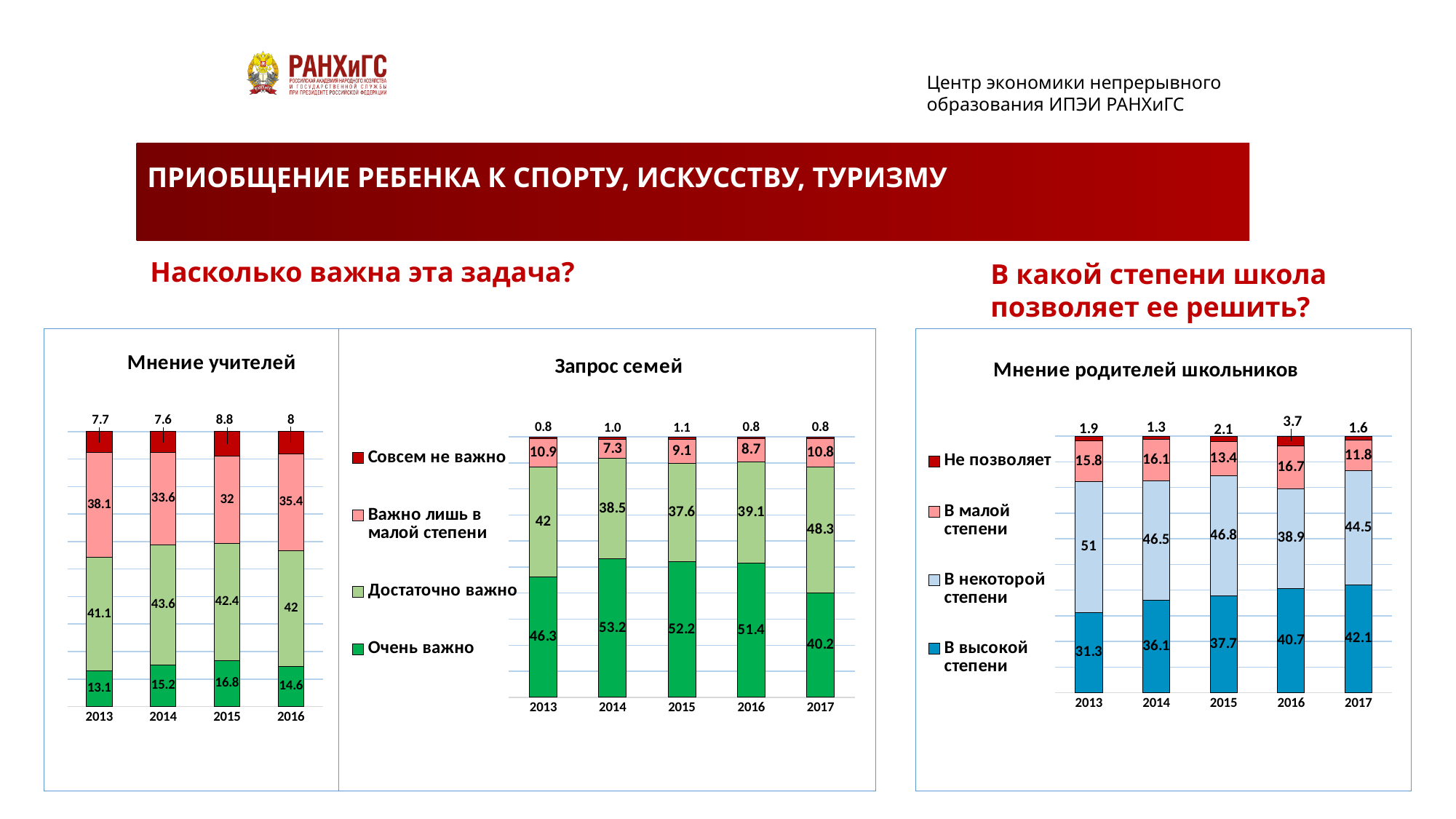
In the chart 'Запрос семей', what is the value for 'Очень важно' in 2014? 53.2 How many series does the legend of the chart 'Мнение родителей школьников' list? 4 In the chart 'Мнение учителей', what is the difference between the 'Важно лишь в малой степени' values for 2013 and 2015? 6.1 In the chart 'Запрос семей', is the 'Очень важно' value larger in 2013 or in 2017? 2013 In the chart 'Запрос семей', what is the total of the stacked bar for 2016? 100 In the chart 'Мнение родителей школьников', what is the value for 'В некоторой степени' in 2013? 51 In the chart 'Мнение родителей школьников', which year has the lowest value for 'В высокой степени'? 2013 What kind of chart is 'Запрос семей'? Stacked bar chart In the chart 'Запрос семей', which year has the highest value for 'Достаточно важно'? 2017 In the chart 'Мнение учителей', what is the value for 'Очень важно' in 2015? 16.8 How many years are shown on the x axis of the chart 'Мнение учителей'? 4 In the chart 'Мнение родителей школьников', does the 'В высокой степени' value rise or fall from 2013 to 2017? Rise